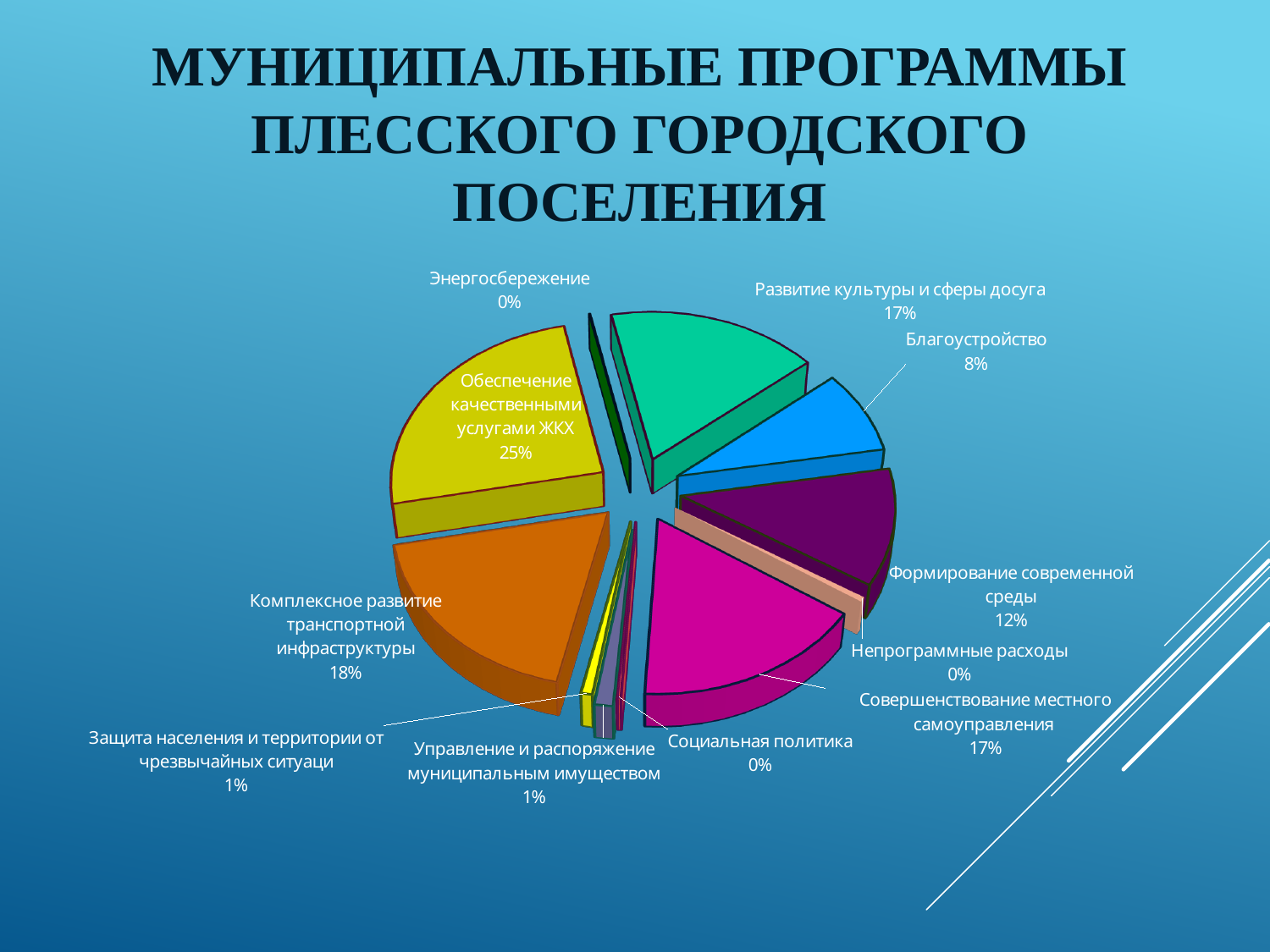
What share of the pie does "Обеспечение качественными услугами ЖКХ" have? 25% What percentage is shown for "Формирование современной среды"? 12% How many categories are shown in the pie chart? 11 What percentage is shown for "Комплексное развитие транспортной инфраструктуры"? 18% How many categories are labelled with 0%? 3 What is the title of the slide? МУНИЦИПАЛЬНЫЕ ПРОГРАММЫ ПЛЕССКОГО ГОРОДСКОГО ПОСЕЛЕНИЯ What percentage is shown for "Благоустройство"? 8% What is the difference in percentage points between "Обеспечение качественными услугами ЖКХ" and "Комплексное развитие транспортной инфраструктуры"? 7 What kind of chart is shown on the slide? Pie chart What percentage is shown for "Совершенствование местного самоуправления"? 17% Which category has the largest share of the pie? Обеспечение качественными услугами ЖКХ Which is larger: the share for "Развитие культуры и сферы досуга" or the share for "Благоустройство"? Развитие культуры и сферы досуга